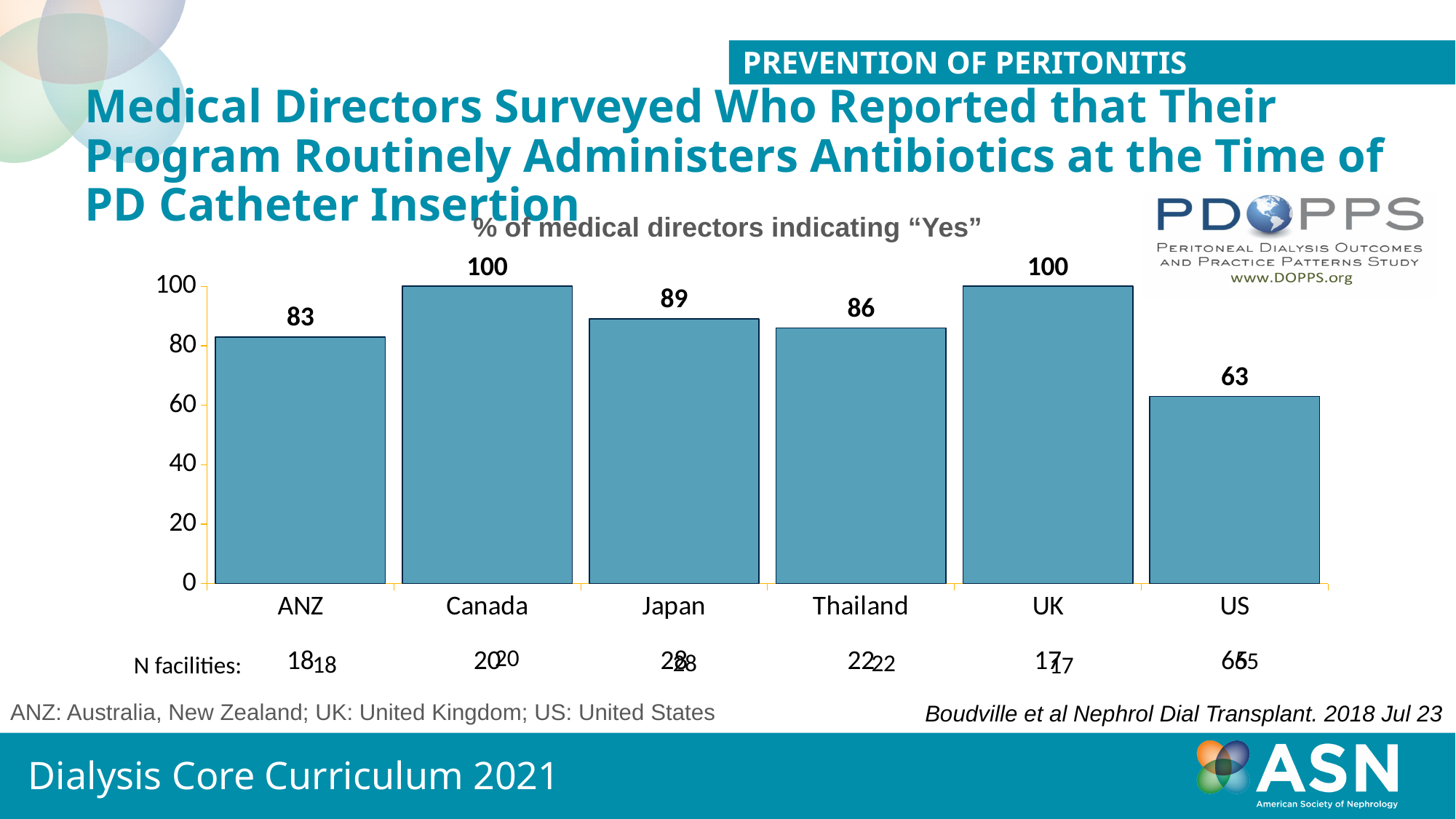
What is the title of the chart's value axis description shown above the bars? % of medical directors indicating "Yes" What type of chart is shown on the slide? Bar chart Is the value for the US greater or less than 80? less What percentage of medical directors in Japan indicated "Yes"? 89 Which countries share the highest value of 100? Canada and UK What is the difference between the values for Japan and ANZ? 6 What is the value shown for Thailand? 86 How many countries or regions are shown on the x axis? 6 What is the difference between the values for Canada and the US? 37 Which has a higher value, Japan or Thailand? Japan Which country has the lowest percentage of medical directors indicating "Yes"? US What is the value shown for ANZ? 83